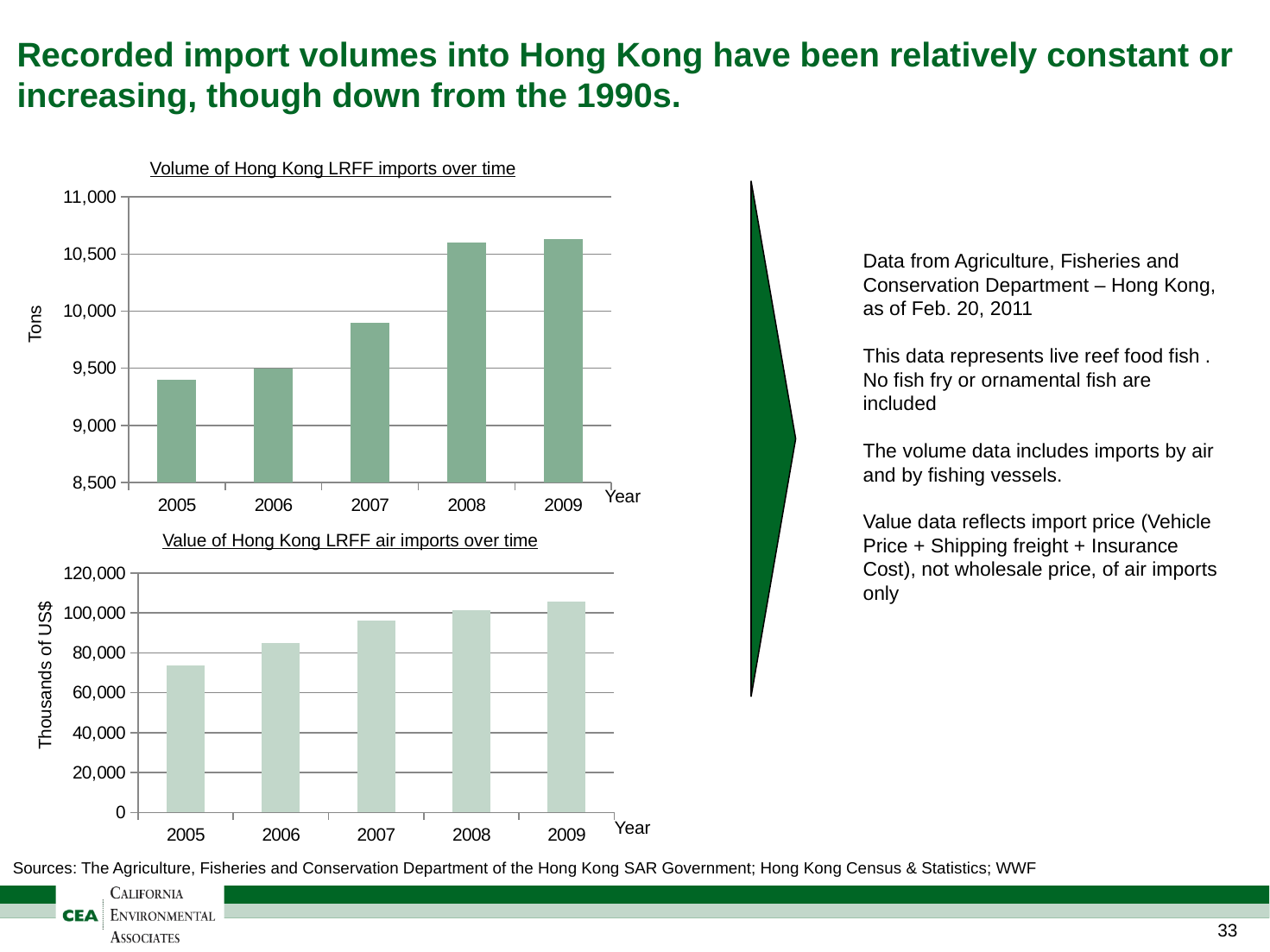
In the chart titled 'Volume of Hong Kong LRFF imports over time', is the value for 2008 greater or less than 10,500? greater In the chart titled 'Value of Hong Kong LRFF air imports over time', is the value for 2005 greater or less than 80,000? less In the chart titled 'Volume of Hong Kong LRFF imports over time', is the value for 2007 greater or less than 10,000? less In the chart titled 'Value of Hong Kong LRFF air imports over time', which year has the lowest value? 2005 In the chart titled 'Volume of Hong Kong LRFF imports over time', which is larger, the value for 2008 or the value for 2006? 2008 In the chart titled 'Volume of Hong Kong LRFF imports over time', what unit is shown on the y axis? Tons In the chart titled 'Volume of Hong Kong LRFF imports over time', how many years are shown on the x axis? 5 In the chart titled 'Value of Hong Kong LRFF air imports over time', do the values rise or fall from 2005 to 2009? rise In the chart titled 'Value of Hong Kong LRFF air imports over time', which year has the highest value? 2009 What type of chart is the chart titled 'Value of Hong Kong LRFF air imports over time'? bar chart